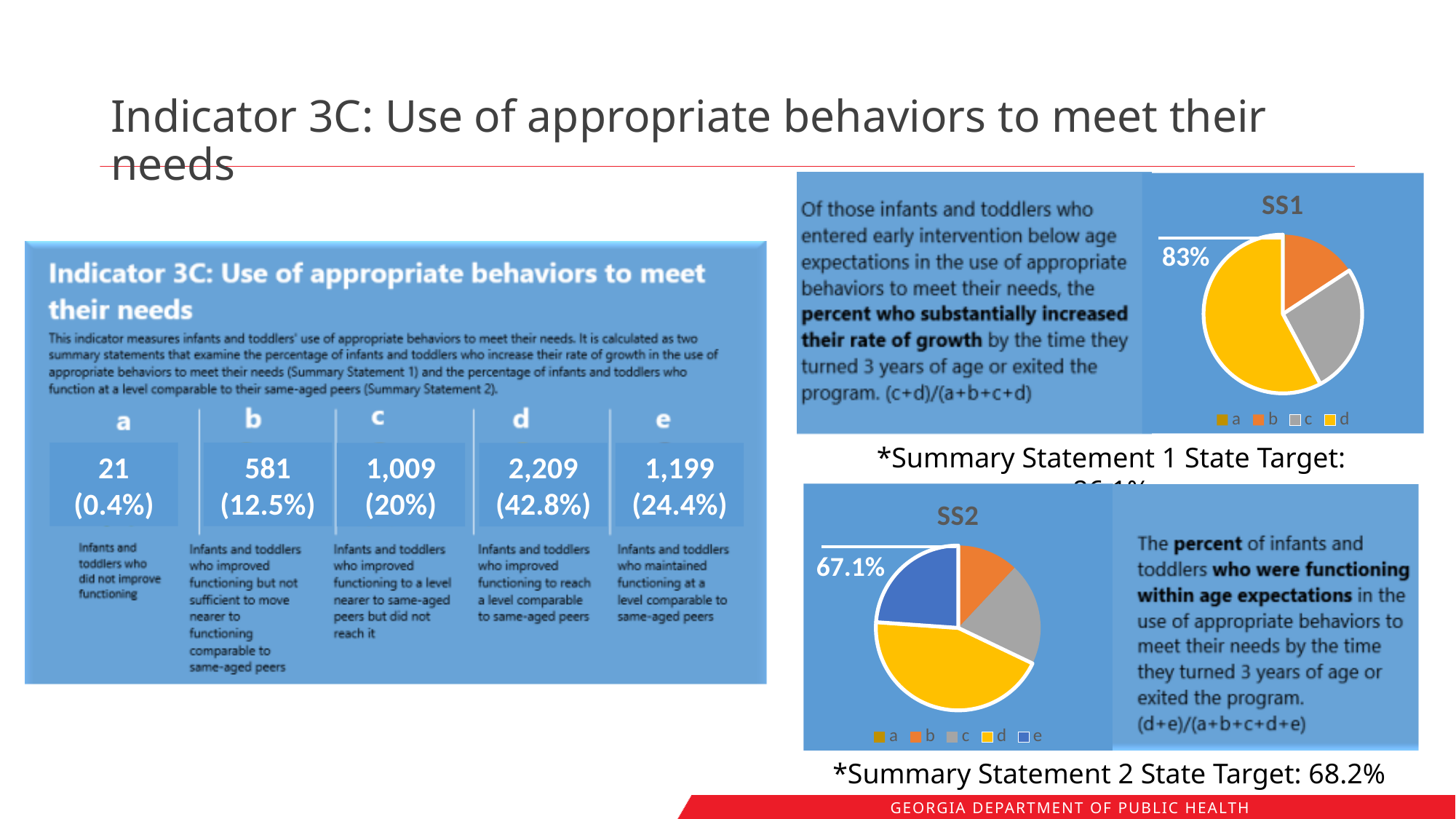
What kind of chart is the SS2 chart? pie chart How many entries does the legend of the SS2 chart list? 5 What percentage is printed on the SS2 pie chart? 67.1% In the SS1 pie chart, which slice is larger, b or c? c In the SS1 pie chart, which category has the largest slice? d What percentage is printed on the SS1 pie chart? 83% In the SS2 pie chart, what colour is the slice for category e? blue What kind of chart is the SS1 chart? pie chart In the SS2 pie chart, which category has the largest slice? d In the SS2 pie chart, which slice is larger, b or e? e How many entries does the legend of the SS1 chart list? 4 What is the title of the pie chart in the upper right of the slide? SS1